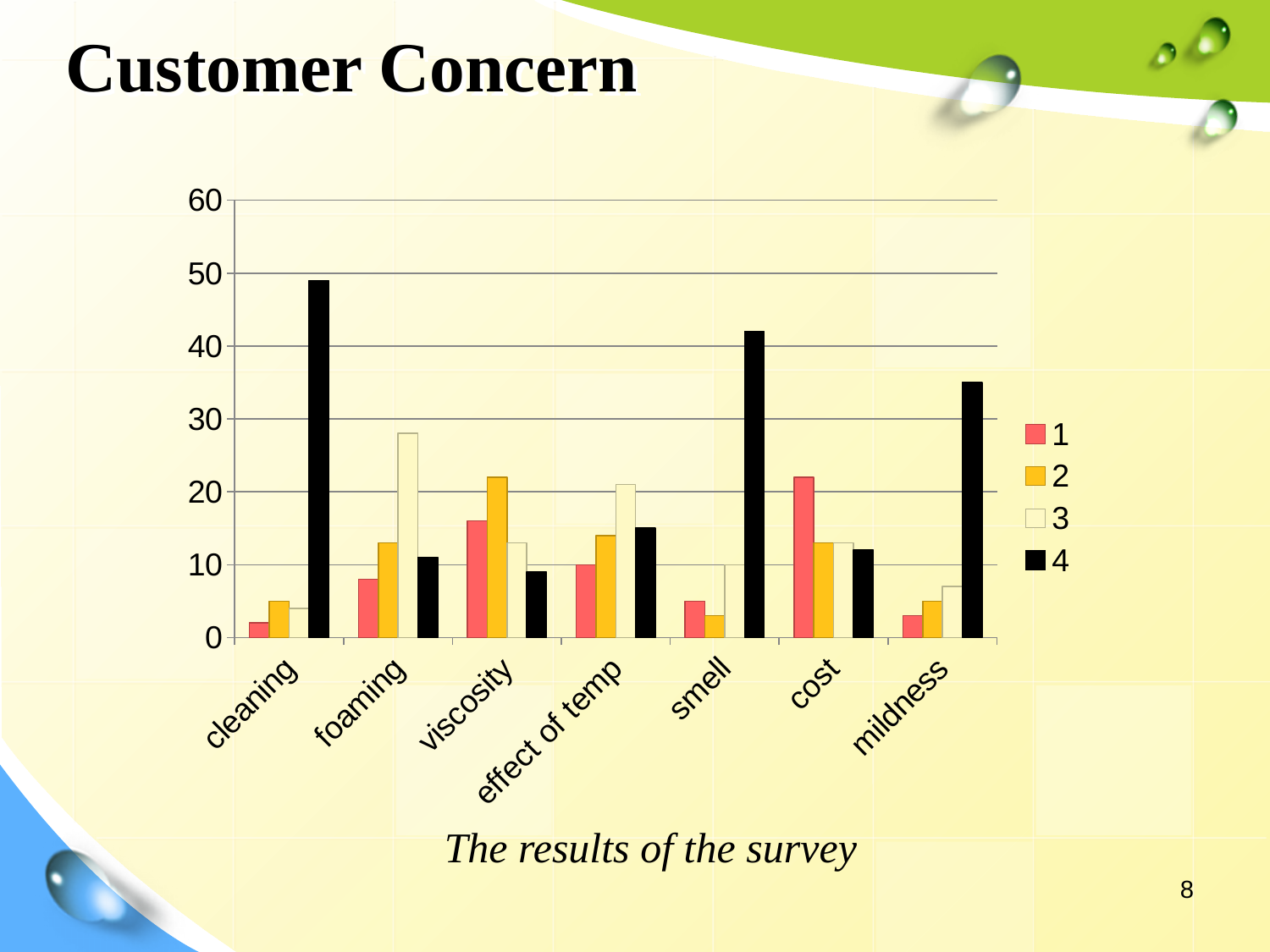
What kind of chart is shown on the slide? bar chart How many series does the chart's legend list? 4 For series 4, which category has the lowest value? viscosity Is the value of series 4 for cleaning greater or less than 40? greater Is the value of series 1 for cleaning greater or less than 10? less For series 3, which category has the highest value? foaming Which is larger: the series 4 value for cleaning or the series 4 value for smell? cleaning How many categories are shown on the x axis of the chart? 7 What are the entries listed in the chart's legend? 1, 2, 3, 4 Is the value of series 3 for foaming greater or less than 20? greater For series 1, which category has the highest value? cost For series 4, which category has the highest value? cleaning